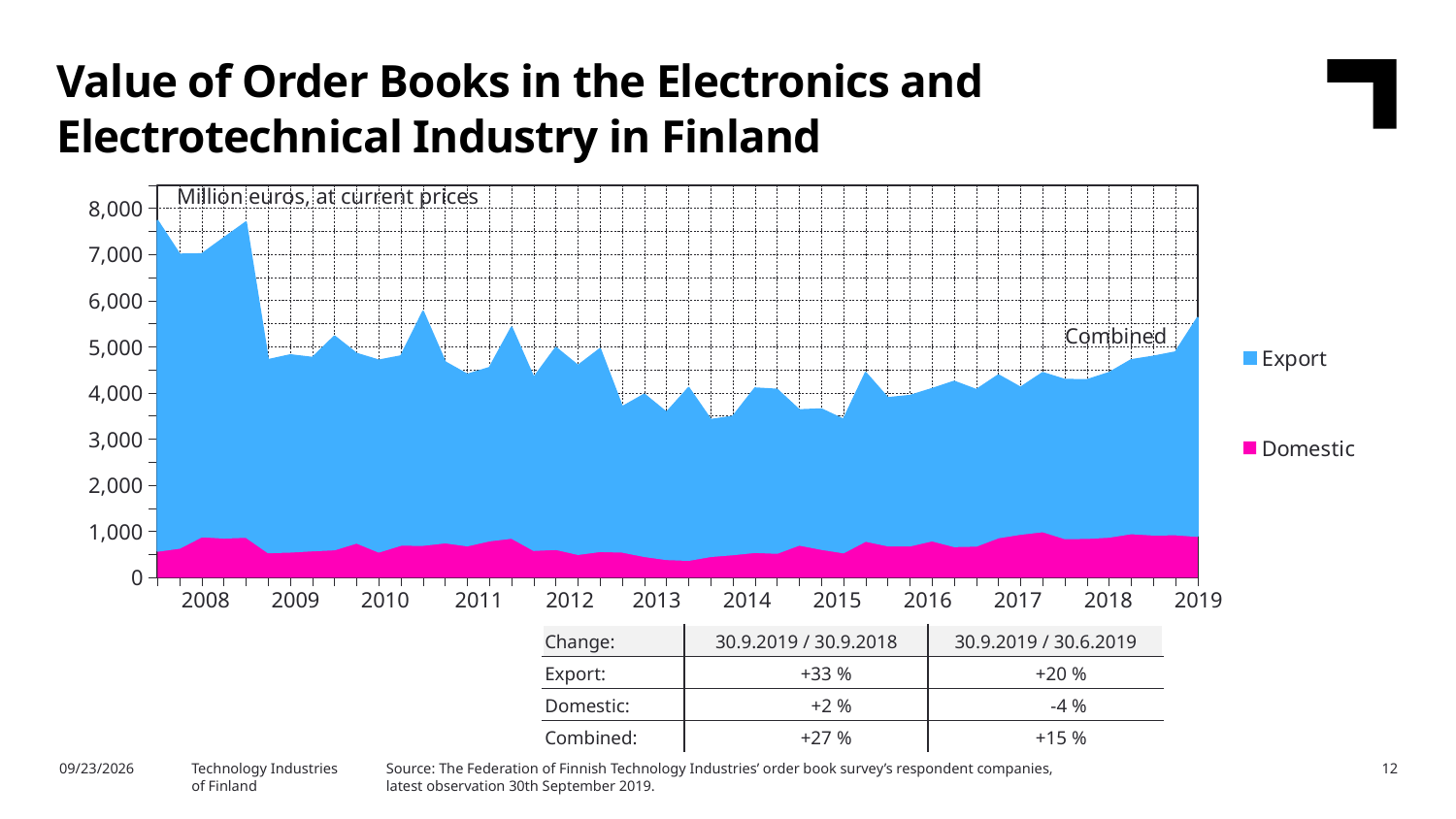
What unit is stated for the values on the chart? Million euros, at current prices How many series does the chart legend list? 2 How many year labels are shown along the x axis of the chart? 12 Which two series are listed in the chart legend? Export and Domestic Is the combined value at the end of 2019 greater or less than 5,000? greater Is the combined value at the start of 2008 greater or less than 7,000? greater Which series is larger throughout the period, Export or Domestic? Export Is the combined value in 2014 greater or less than 5,000? less Does the combined value of order books rise or fall between 2008 and 2013? fall In which year does the combined value of order books reach its highest level? 2008 What kind of chart is shown on the slide? Area chart